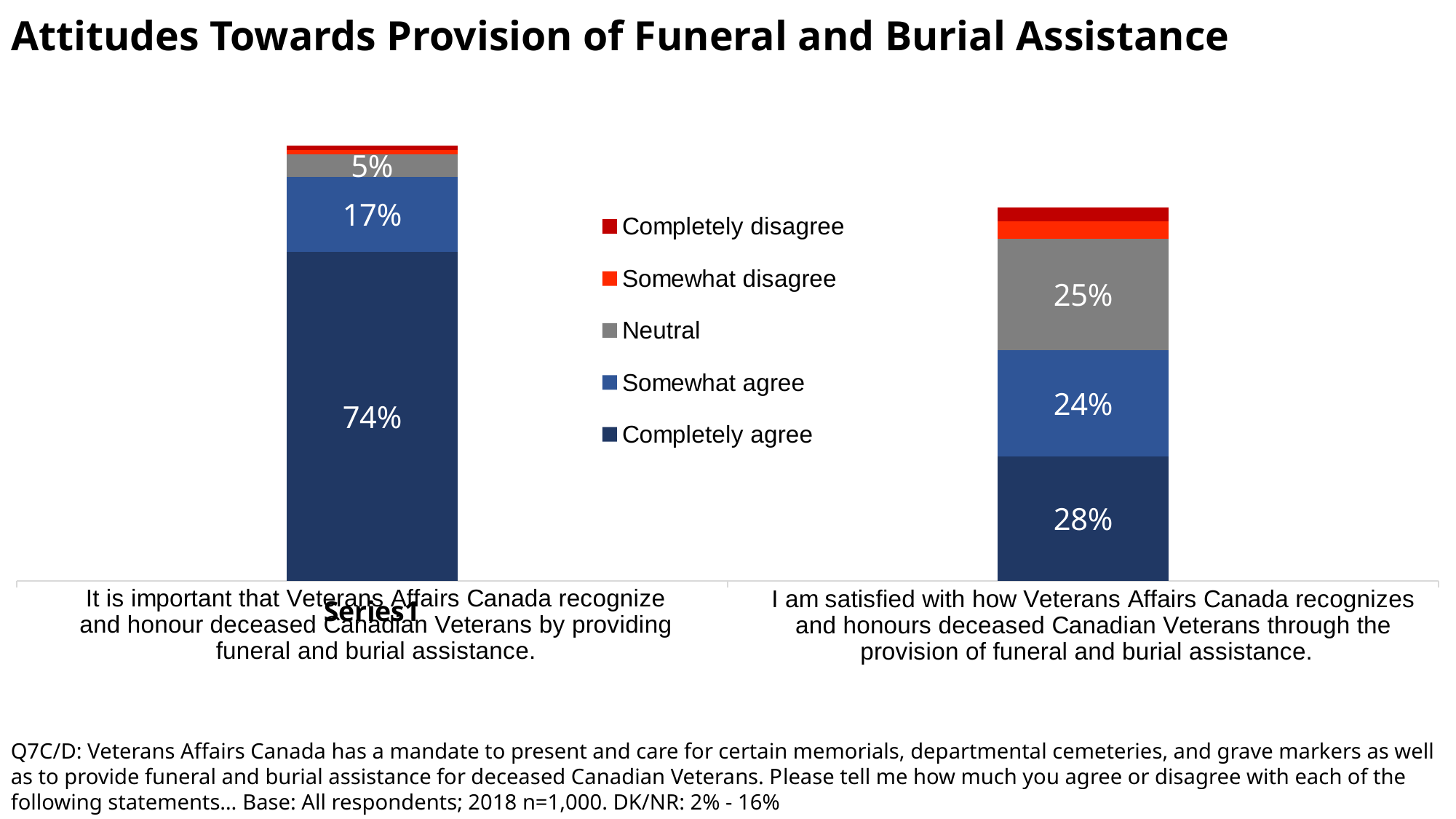
How much higher is the 'Completely agree' share for the importance statement than for the satisfaction statement? 46 percentage points What type of chart is shown on the slide? Stacked bar chart What is the Neutral share for the statement about being satisfied with how Veterans Affairs Canada recognizes and honours deceased Canadian Veterans? 25% What percentage completely agree with the statement 'I am satisfied with how Veterans Affairs Canada recognizes and honours deceased Canadian Veterans through the provision of funeral and burial assistance'? 28% What percentage of respondents somewhat agree with the statement 'I am satisfied with how Veterans Affairs Canada recognizes and honours deceased Canadian Veterans through the provision of funeral and burial assistance'? 24% What percentage of respondents completely agree that it is important that Veterans Affairs Canada recognize and honour deceased Canadian Veterans by providing funeral and burial assistance? 74% How many response categories does the legend list? 5 How many statements (bars) are shown in the chart? 2 What is the Neutral share for the statement that it is important that Veterans Affairs Canada recognize and honour deceased Canadian Veterans? 5% What is the title of the chart? Attitudes Towards Provision of Funeral and Burial Assistance Which statement has the larger 'Somewhat agree' share: the importance statement or the satisfaction statement? The satisfaction statement Which response category is the largest for the statement that it is important that Veterans Affairs Canada recognize and honour deceased Canadian Veterans? Completely agree